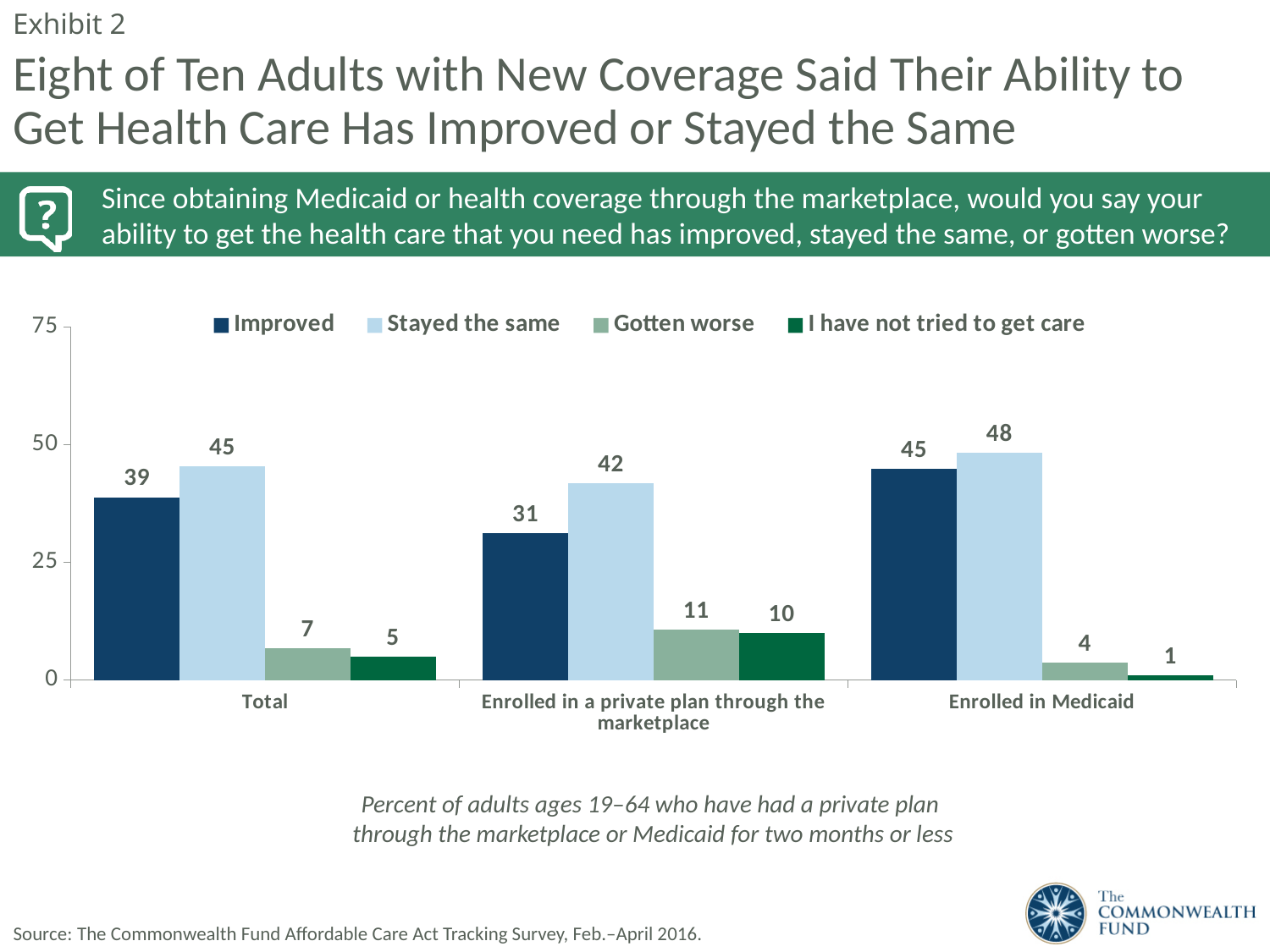
What is the value for "I have not tried to get care" among those enrolled in Medicaid? 1 What is the value for "Stayed the same" among those enrolled in Medicaid? 48 Which group has the highest value for "Improved"? Enrolled in Medicaid How many groups are shown on the x axis? 3 What is the value for "Gotten worse" among those enrolled in a private plan through the marketplace? 11 What is the value for "Improved" in the Total group? 39 How many series does the legend list? 4 What is the difference between "Stayed the same" and "Improved" among those enrolled in a private plan through the marketplace? 11 Which legend entry is shown in the darkest green colour? I have not tried to get care Which response category has the lowest value in the Total group? I have not tried to get care Which is larger: "Gotten worse" for those enrolled in a private plan through the marketplace, or "Gotten worse" for those enrolled in Medicaid? Enrolled in a private plan through the marketplace What kind of chart is shown on the slide? Bar chart